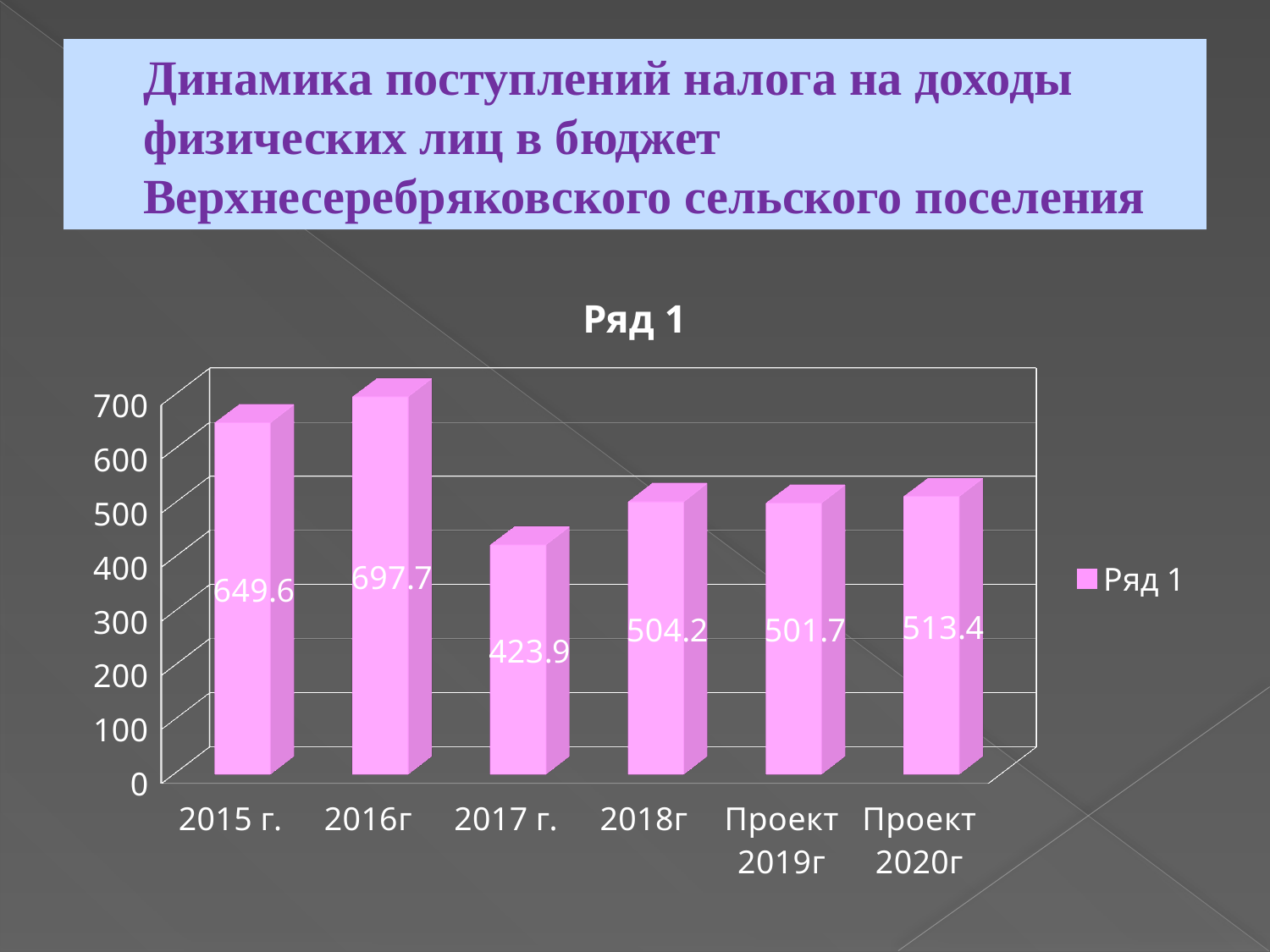
What is the value for Проект 2020г? 513.4 What is the difference between the values for 2018г and 2017 г.? 80.3 What is the name of the series shown in the legend? Ряд 1 Which category has the lowest value? 2017 г. How many categories are shown on the x axis? 6 Which category has the highest value? 2016г What kind of chart is shown on the slide? bar chart Which is larger, the value for 2015 г. or the value for 2018г? 2015 г. What is the value for 2016г? 697.7 What is the value for 2017 г.? 423.9 Is the value for 2017 г. greater or less than 500? less What is the difference between the values for 2016г and 2015 г.? 48.1